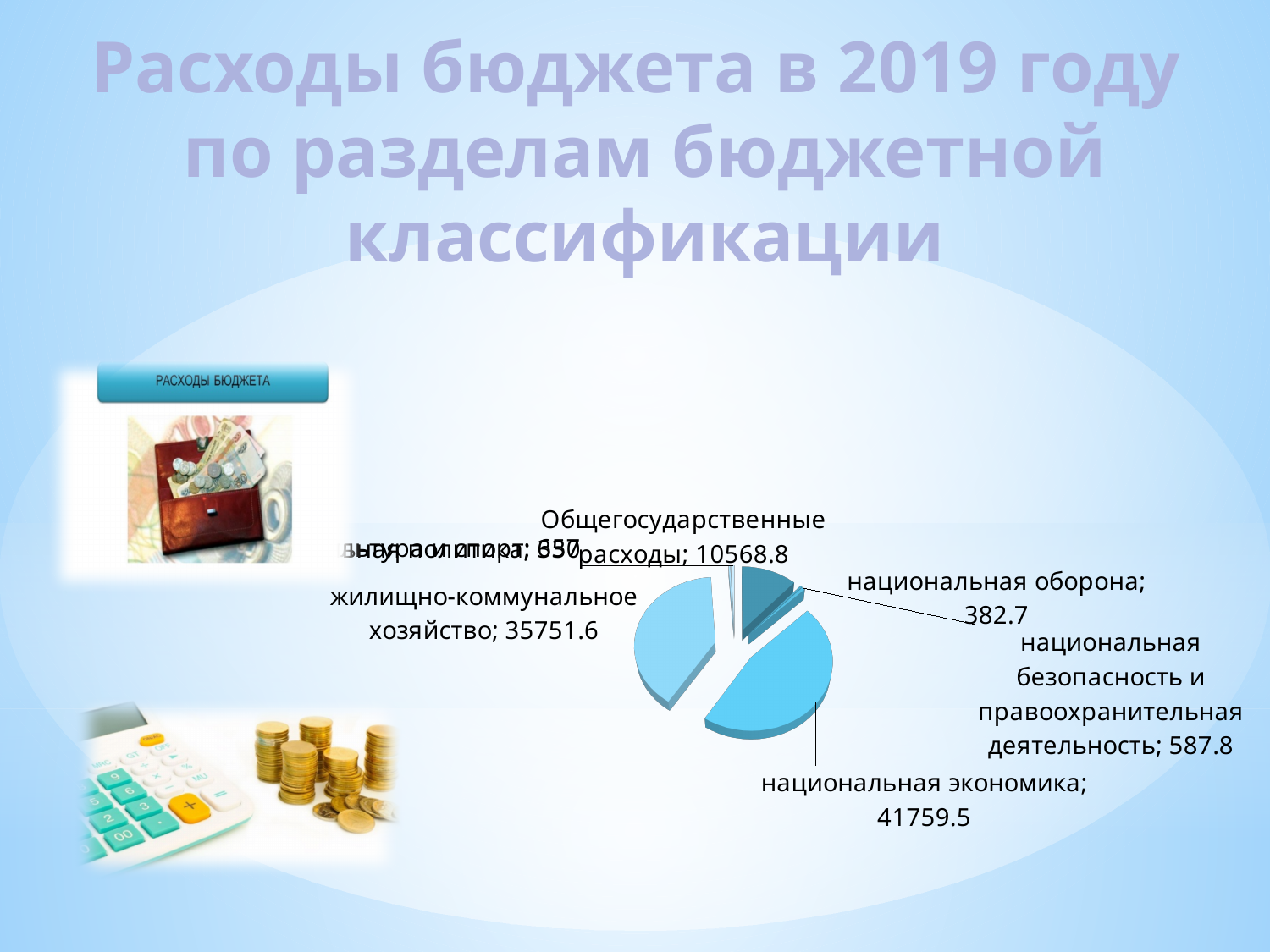
Which category has the largest slice of the pie? национальная экономика What is the difference between национальная экономика and жилищно-коммунальное хозяйство? 6007.9 What is the value for Общегосударственные расходы? 10568.8 What kind of chart is shown on the slide? pie chart What is the value for национальная оборона? 382.7 Which is larger, национальная экономика or жилищно-коммунальное хозяйство? национальная экономика What is the difference between национальная безопасность и правоохранительная деятельность and национальная оборона? 205.1 What is the value for национальная экономика? 41759.5 What is the title of the slide containing the chart? Расходы бюджета в 2019 году по разделам бюджетной классификации What is the value for жилищно-коммунальное хозяйство? 35751.6 Which is larger, национальная оборона or национальная безопасность и правоохранительная деятельность? национальная безопасность и правоохранительная деятельность What is the value for национальная безопасность и правоохранительная деятельность? 587.8